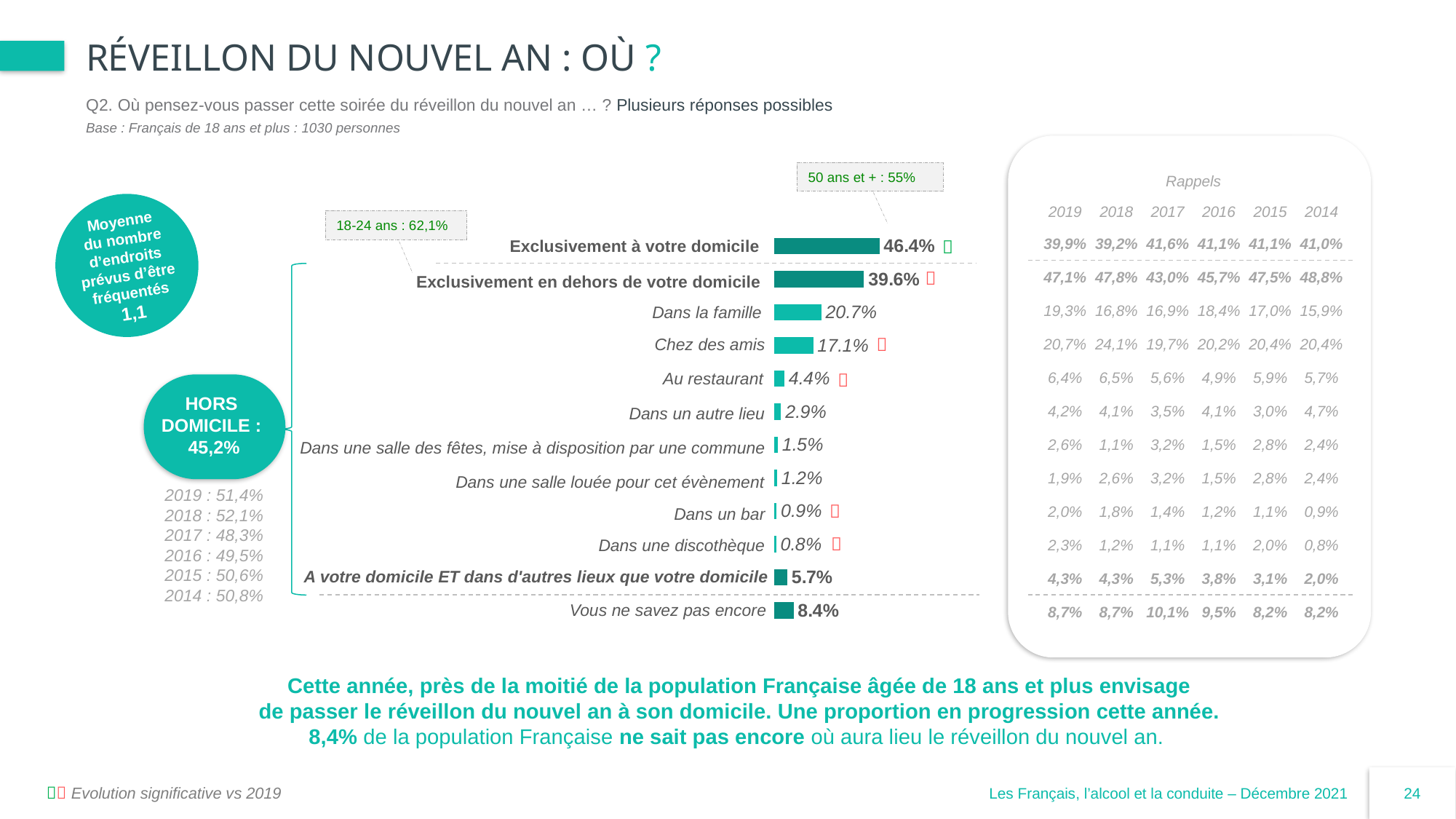
Which category has the lowest value in the chart? Dans une discothèque What is the difference between "Au restaurant" and "Dans un autre lieu"? 1.5% Which is larger: "Dans la famille" or "Chez des amis"? Dans la famille How many categories (bars) does the chart show? 12 What kind of chart is shown on the slide? Bar chart What is the value for "Dans la famille"? 20.7% Which category has the highest value in the chart? Exclusivement à votre domicile What is the value for "Exclusivement à votre domicile"? 46.4% What is the value for "Vous ne savez pas encore"? 8.4% What is the difference between "Exclusivement à votre domicile" and "Exclusivement en dehors de votre domicile"? 6.8% What is the value for "Dans un bar"? 0.9% What is the value for "A votre domicile ET dans d'autres lieux que votre domicile"? 5.7%